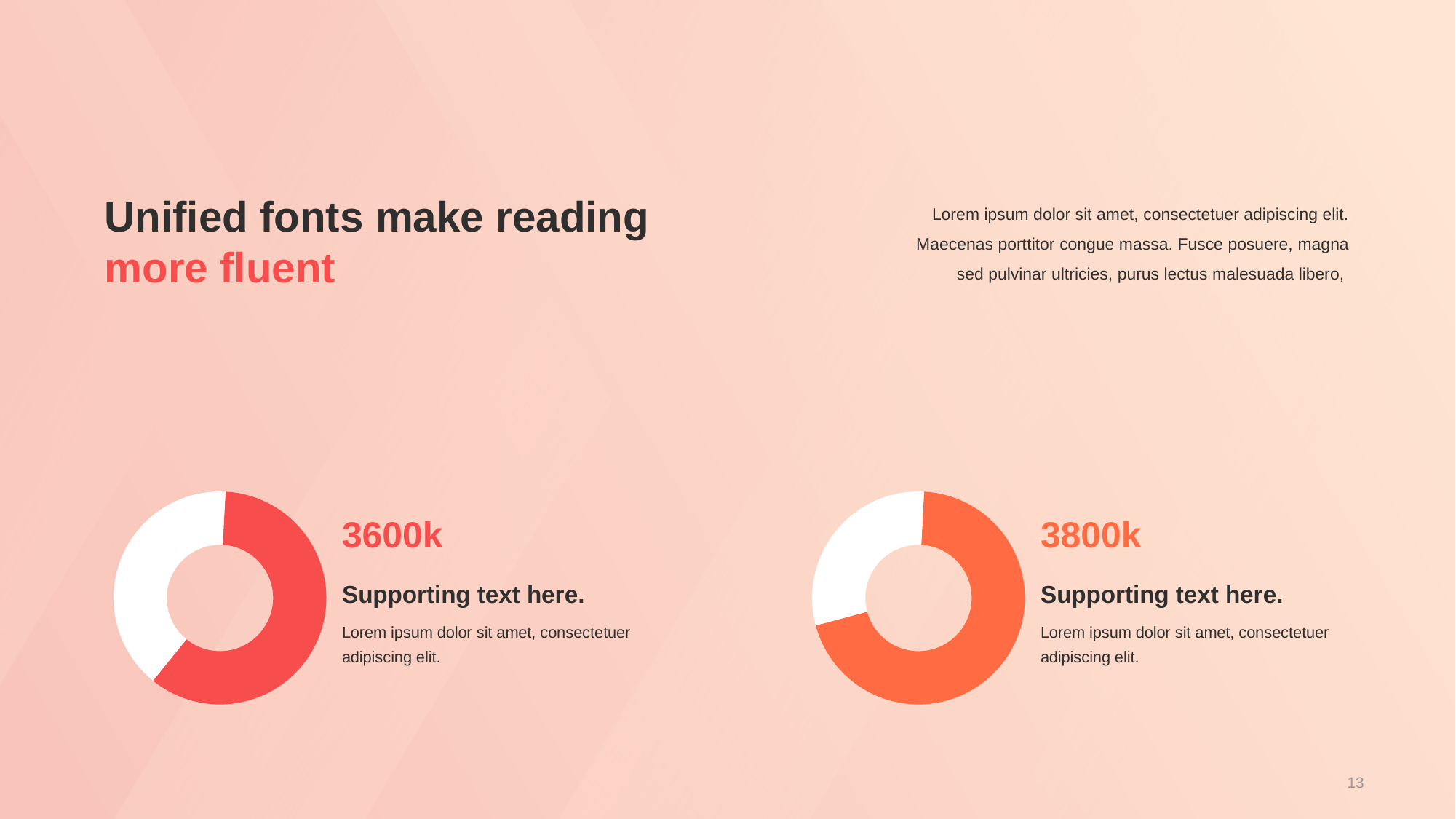
In the left donut chart, which slice is larger, the red slice or the white slice? The red slice How many slices does the left donut chart have? 2 Which donut chart has the larger figure displayed beside it, the left one or the right one? The right one What kind of chart is shown on the left side of the slide? Donut (pie) chart In the right donut chart, which slice is larger, the orange slice or the white slice? The orange slice How many slices does the right donut chart have? 2 What figure is displayed next to the left donut chart? 3600k How many donut charts are on the slide? 2 What figure is displayed next to the right donut chart? 3800k What colour is the filled slice of the left donut chart? Red What colour is the filled slice of the right donut chart? Orange